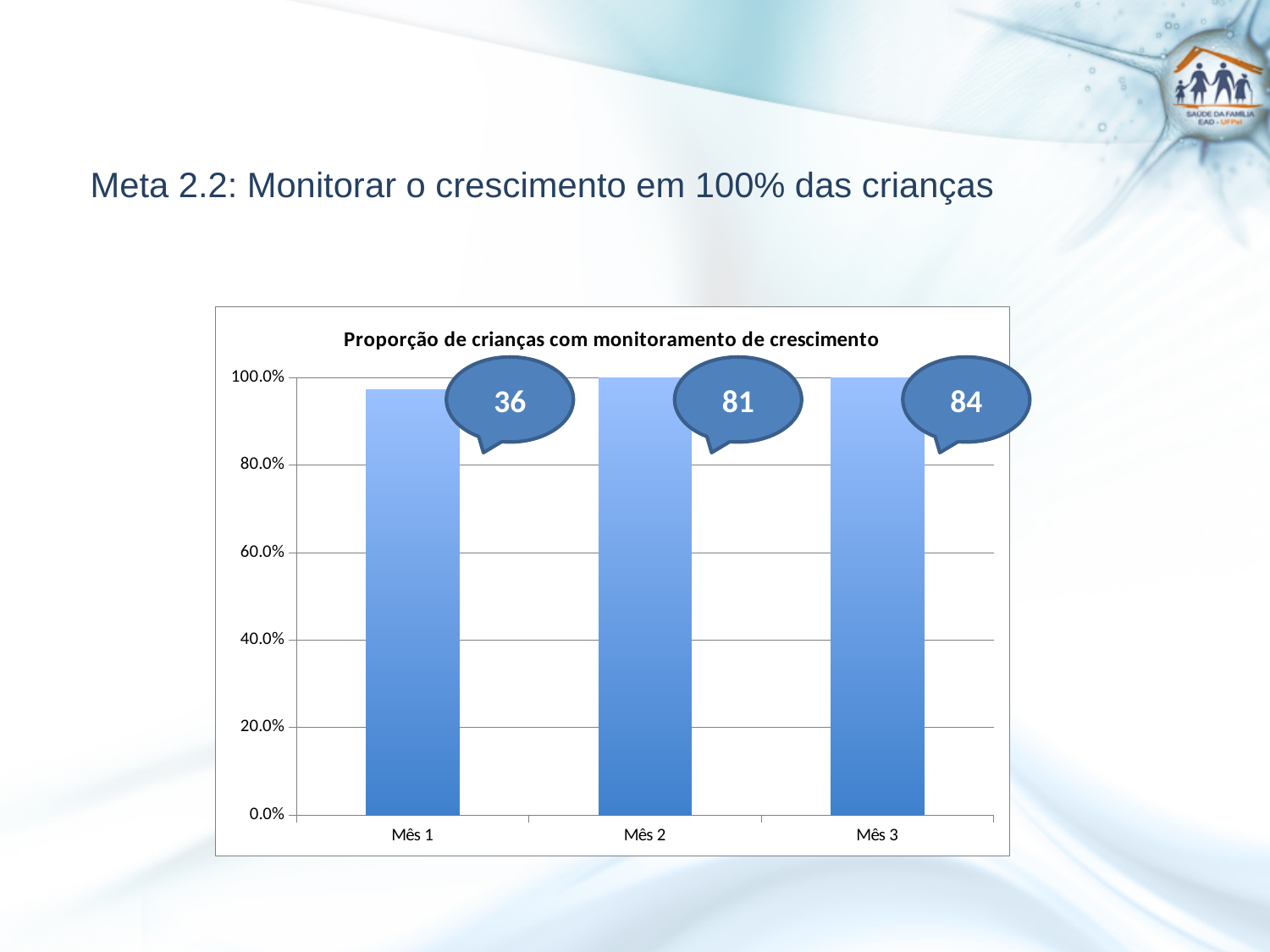
What kind of chart is shown on the slide? bar chart Which is larger, the value for Mês 1 or the value for Mês 2? Mês 2 Do the values rise or fall from Mês 1 to Mês 3? rise What is the title of the chart? Proporção de crianças com monitoramento de crescimento Which month has the lowest value in the chart? Mês 1 Is the value for Mês 1 greater or less than 80.0%? greater How many months (categories) are shown on the x axis of the chart? 3 What number is shown in the callout above the Mês 1 bar? 36 What is the value for Mês 3 in the chart? 100.0% What is the value for Mês 2 in the chart? 100.0% What is the highest value shown on the y axis of the chart? 100.0%